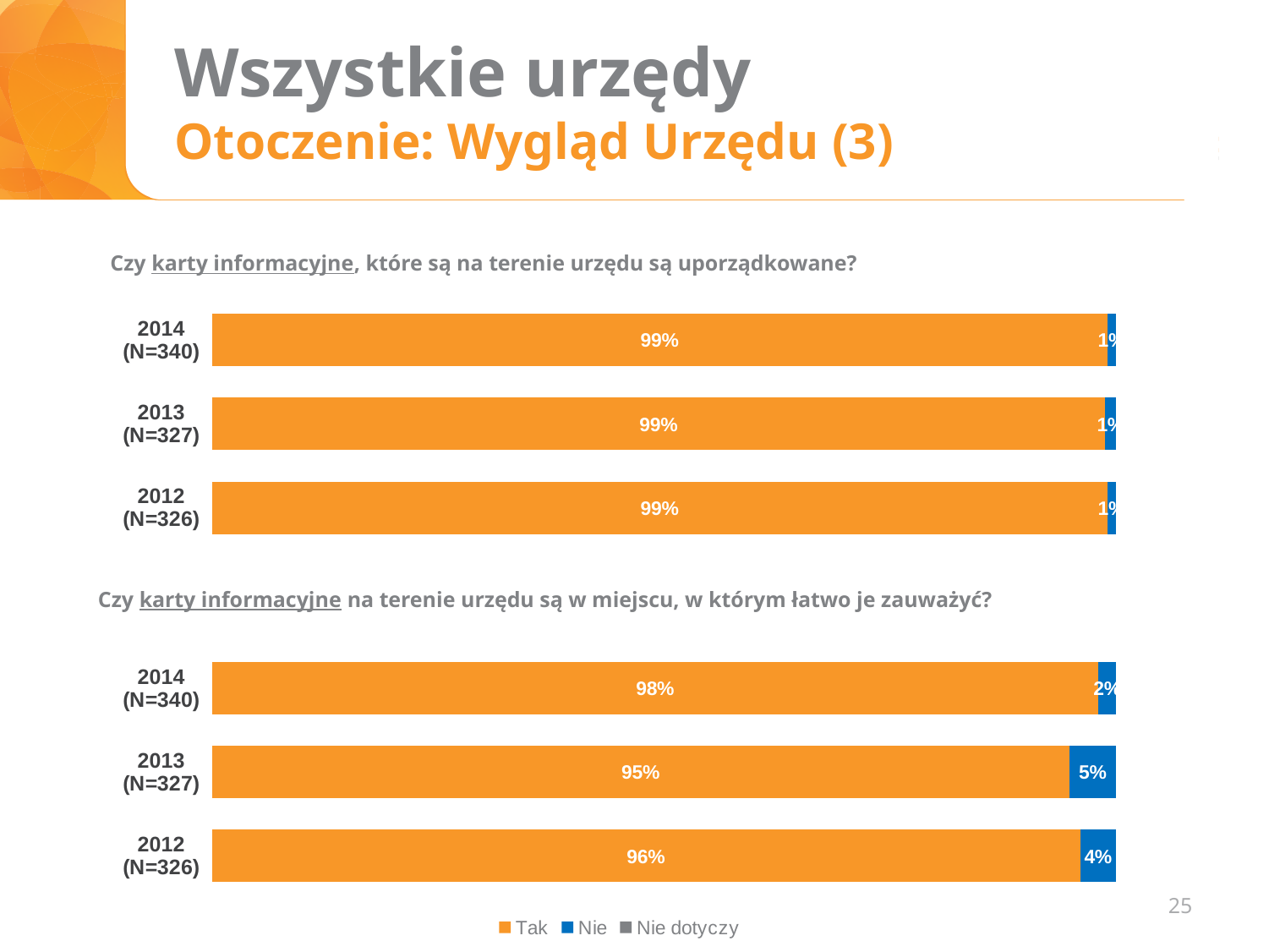
In the bottom chart, what is the difference between the Tak values for 2014 and 2013? 3 percentage points In the bottom chart, which year has the highest value for Tak? 2014 (N=340) How many series does the legend list? 3 In the top chart, what is the value for Tak in 2013 (N=327)? 99% In the bottom chart, what is the value for Tak in 2014 (N=340)? 98% What type of chart is the bottom chart? Stacked bar chart In the bottom chart, what is the value for Tak in 2012 (N=326)? 96% In the bottom chart, is the Nie value larger in 2013 or in 2012? 2013 How many years are shown in the top chart? 3 In the bottom chart, what is the value for Nie in 2013 (N=327)? 5% Which colour represents Tak in the charts? Orange In the bottom chart, which year has the lowest value for Tak? 2013 (N=327)